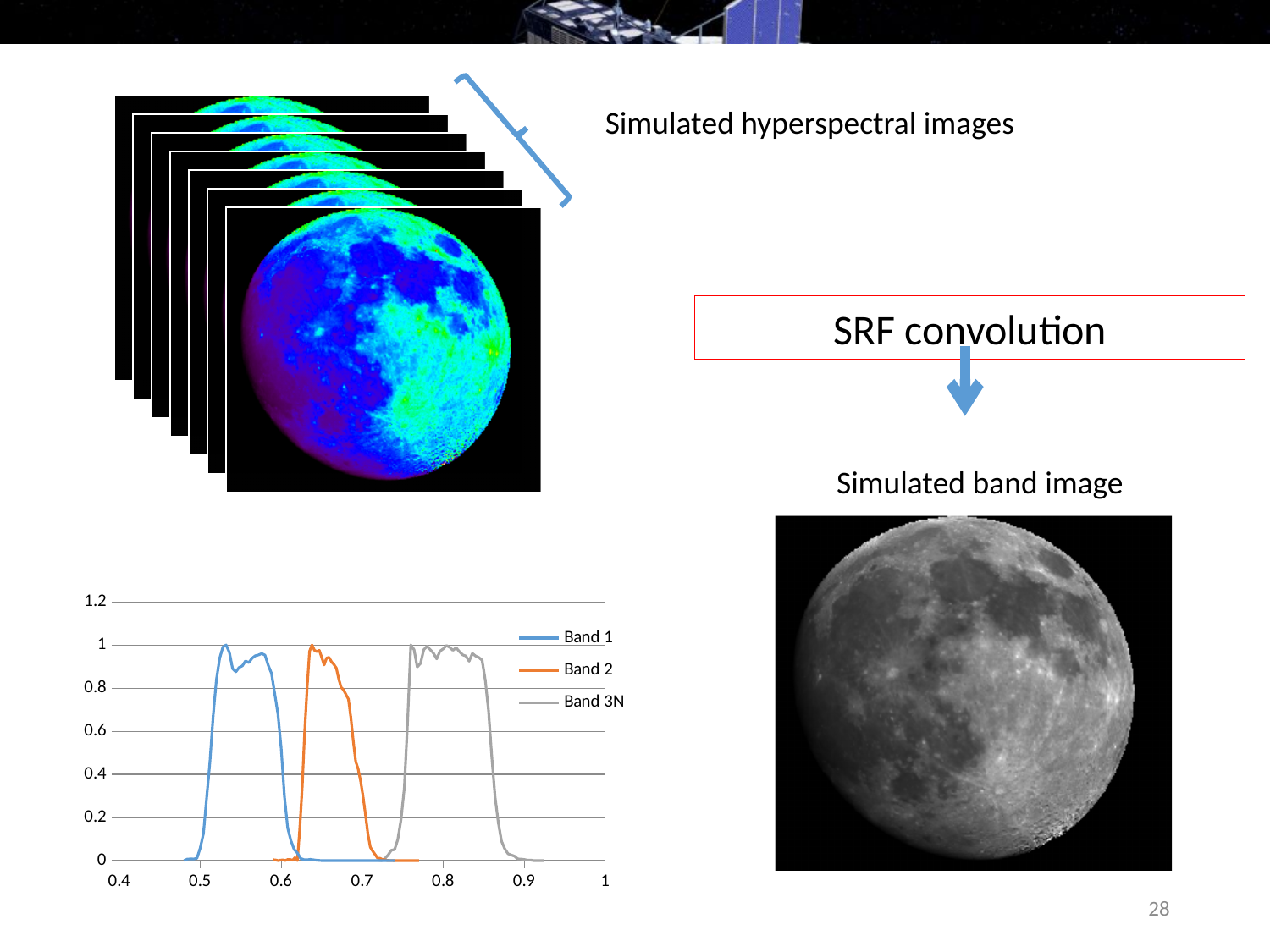
In the line chart, is the value of Band 3N at x = 0.9 greater or less than 0.2? less In the line chart, is the value of Band 3N at x = 0.8 greater or less than 0.8? greater Which colour is used for the Band 2 line in the chart? orange In the line chart, is the value of Band 2 at x = 0.5 greater or less than 0.2? less In the line chart, at x = 0.65, which series has the larger value, Band 1 or Band 2? Band 2 What kind of chart is shown at the bottom left of the slide? line chart How many series does the legend of the line chart list? 3 In the line chart, which series has its peak at the largest x value? Band 3N What is the highest value shown on the y axis of the line chart? 1.2 What are the names of the series in the line chart's legend? Band 1, Band 2, Band 3N